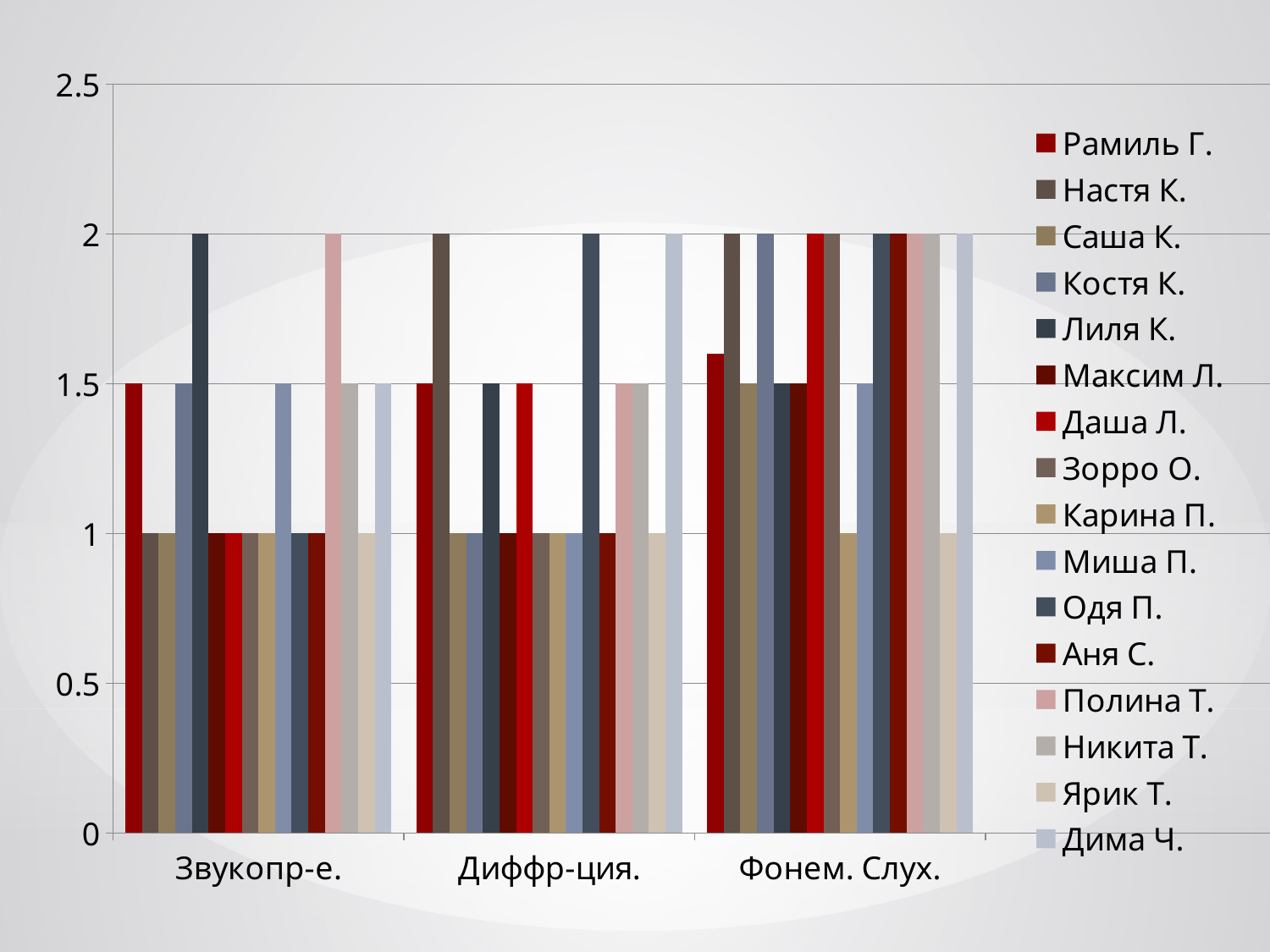
What is the name of the first series listed in the legend? Рамиль Г. What is the value for Карина П. in the Фонем. Слух. category? 1 What is the value for Лиля К. in the Звукопр-е. category? 2 How many categories are shown on the x axis? 3 Which is larger in the Диффр-ция. category: Одя П. or Миша П.? Одя П. What is the value for Настя К. in the Диффр-ция. category? 2 Is the value for Рамиль Г. in the Фонем. Слух. category greater or less than 1.5? greater What kind of chart is shown on the slide? bar chart How many series does the legend list? 16 What is the difference between Полина Т. and Ярик Т. in the Звукопр-е. category? 1 What is the value for Рамиль Г. in the Звукопр-е. category? 1.5 Which category has the lowest value for Саша К.? Звукопр-е. and Диффр-ция. (both 1)